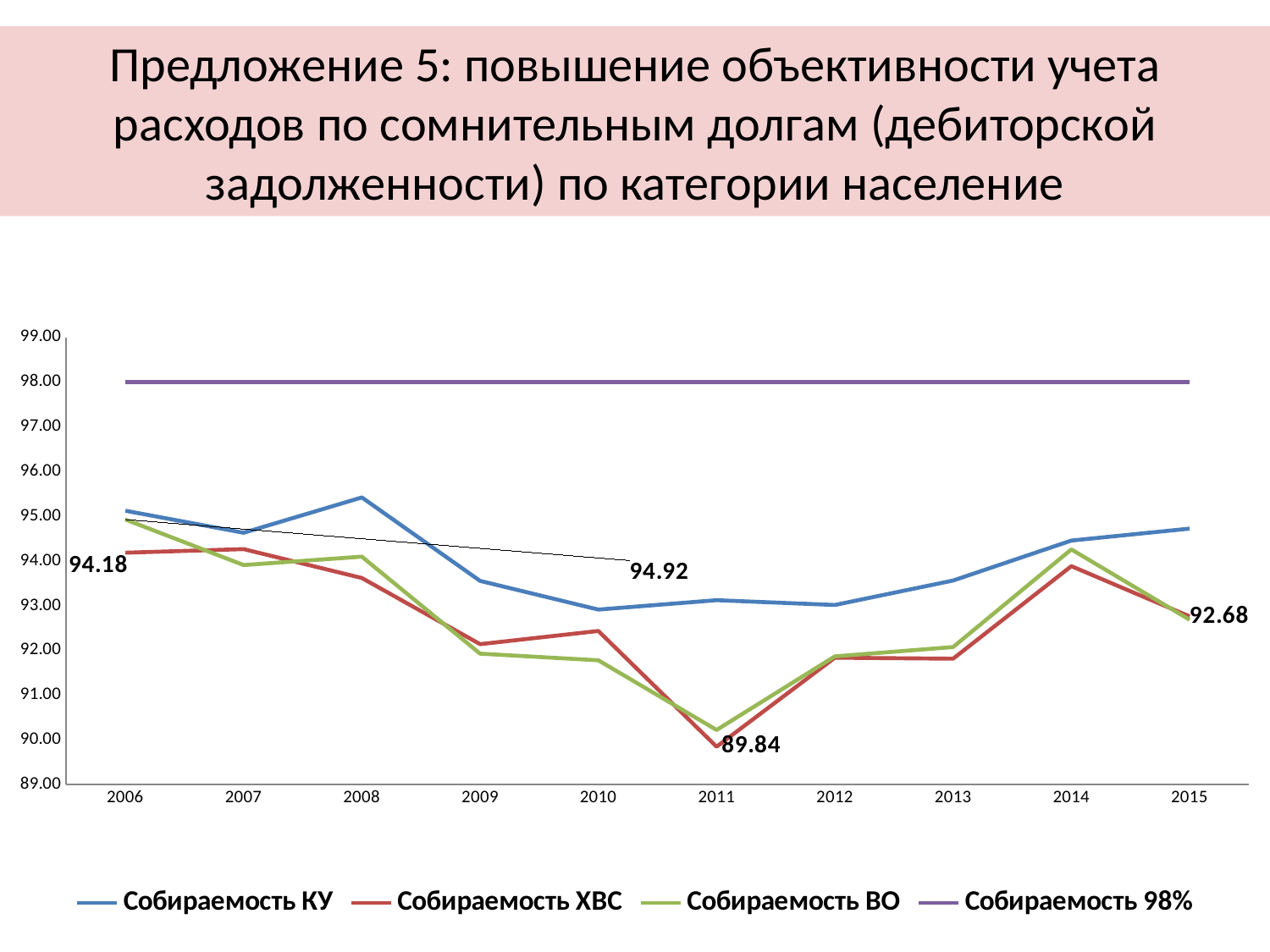
What is the value of Собираемость ХВС in 2006? 94.18 In which year is Собираемость ХВС at its lowest? 2011 How many years are shown on the x axis? 10 In 2008, which is larger: Собираемость КУ or Собираемость ХВС? Собираемость КУ How many series does the legend list? 4 What kind of chart is shown on the slide? line chart What is the difference between the Собираемость ХВС values in 2006 and 2011? 4.34 Which series is drawn as a flat horizontal line across the whole chart? Собираемость 98% What is the value of Собираемость ХВС in 2011? 89.84 Is the value for Собираемость КУ in 2008 greater or less than 95.00? greater Is the value for Собираемость ВО in 2011 greater or less than 91.00? less